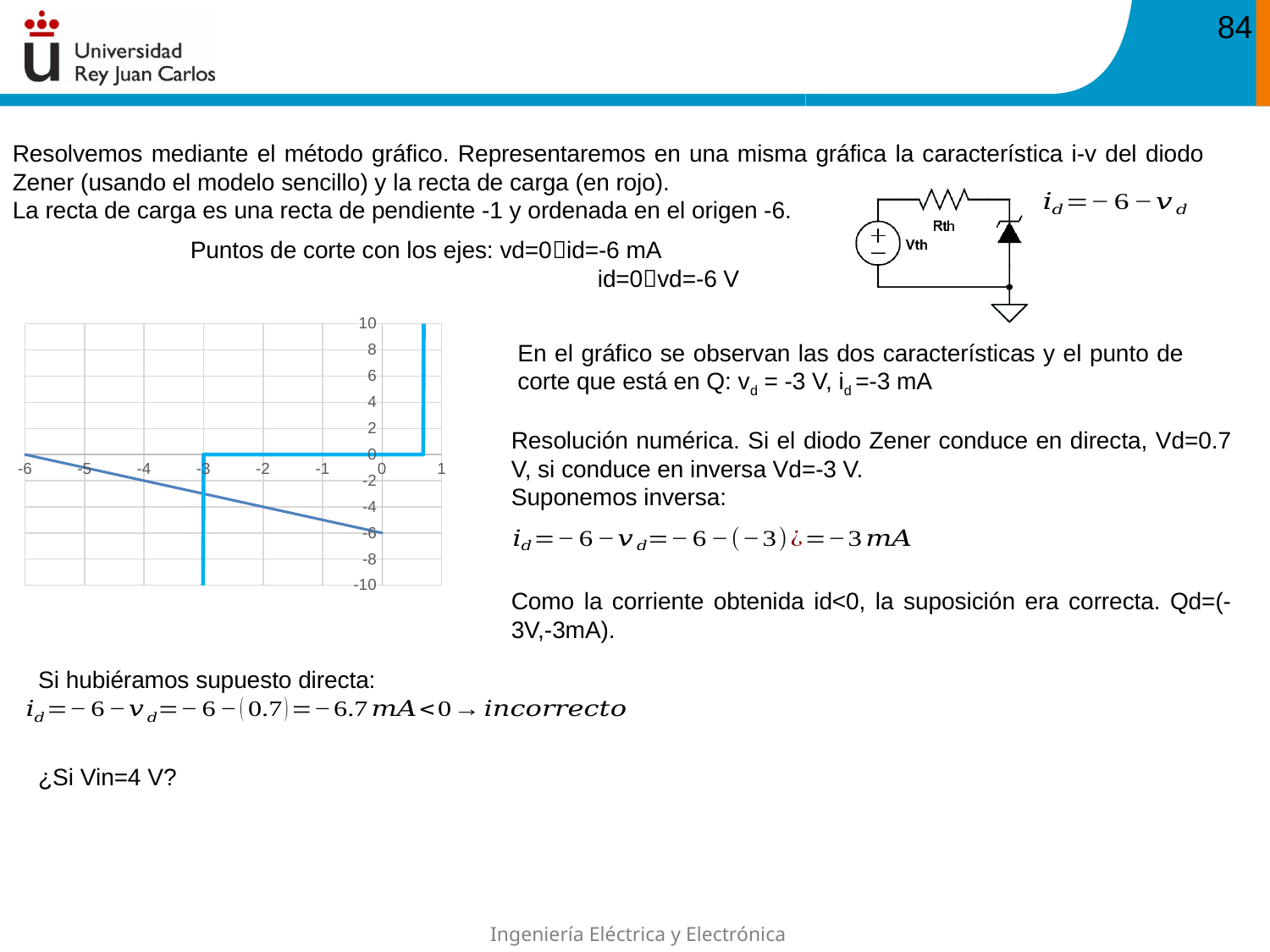
Does the sloped line on the chart rise or fall as the horizontal axis value increases? fall At which horizontal-axis value is the vertical segment of the thick line on the left side of the chart located? -3 At which horizontal-axis value does the sloped line cross the horizontal axis? -6 What kind of chart is shown on the slide? line chart What is the leftmost tick value on the horizontal axis of the chart? -6 What is the rightmost tick value on the horizontal axis of the chart? 1 How many lines are plotted on the chart? 2 At which vertical-axis value does the sloped line cross the vertical axis? -6 Is the value of the sloped line at x = -3 greater or less than 0? less What is the highest value shown on the vertical axis of the chart? 10 Is the value of the sloped line at x = 0 greater or less than -4? less What is the lowest value shown on the vertical axis of the chart? -10